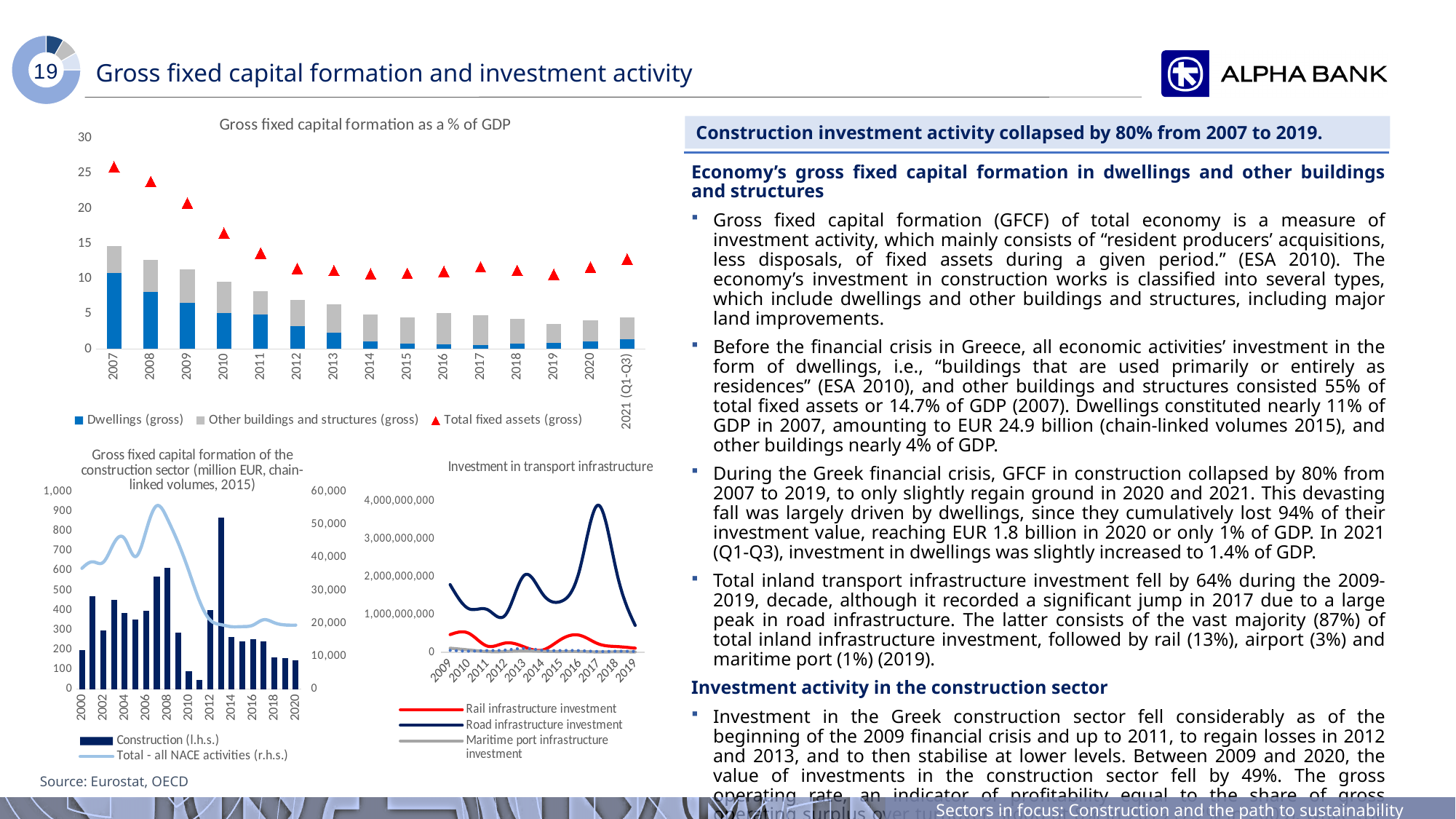
How many time periods are shown on the x axis of the 'Gross fixed capital formation as a % of GDP' chart? 15 In the 'Gross fixed capital formation as a % of GDP' chart, is the Total fixed assets (gross) value for 2010 greater or less than 15? greater What kind of chart is the 'Investment in transport infrastructure' chart? line chart How many series does the legend of the 'Investment in transport infrastructure' chart list? 3 In the 'Gross fixed capital formation of the construction sector' chart, is the Construction (l.h.s.) value for 2013 greater or less than 800? greater In the 'Gross fixed capital formation of the construction sector' chart, which year has the highest Construction (l.h.s.) bar? 2013 In the 'Gross fixed capital formation as a % of GDP' chart, do the Total fixed assets (gross) values rise or fall from 2007 to 2013? fall In the 'Investment in transport infrastructure' chart, is the Road infrastructure investment value for 2017 greater or less than 3,000,000,000? greater In the 'Gross fixed capital formation as a % of GDP' chart, which year has the highest value for Total fixed assets (gross)? 2007 In the 'Investment in transport infrastructure' chart, which series has the highest value in 2017? Road infrastructure investment How many years are plotted on the x axis of the 'Investment in transport infrastructure' chart? 11 How many series does the legend of the 'Gross fixed capital formation as a % of GDP' chart list? 3